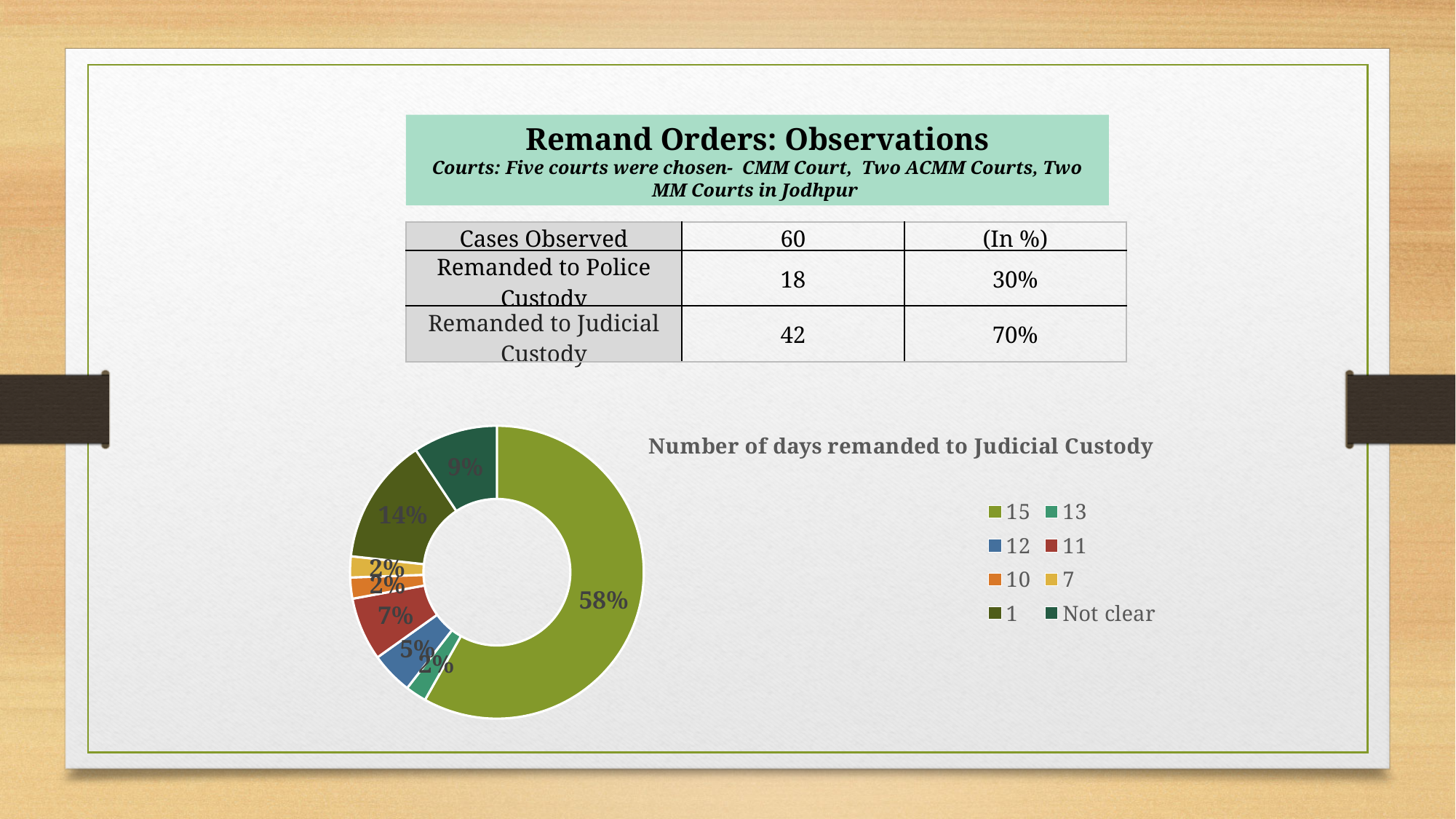
What type of chart is shown on the slide? Doughnut (pie) chart Which is larger, the share for "1" or the share for "Not clear"? 1 What percentage is shown for the category "1" in the chart? 14% Which is larger, the share for "11" or the share for "12"? 11 What is the difference in percentage points between the "15" slice and the "1" slice? 44 What percentage is shown for the category "12"? 5% Which category has the largest share of the chart? 15 What percentage is shown for the category "11"? 7% What is the title of the chart? Number of days remanded to Judicial Custody How many categories does the chart's legend list? 8 What percentage is shown for the "Not clear" category? 9% What share of the doughnut chart does the category "15" represent? 58%